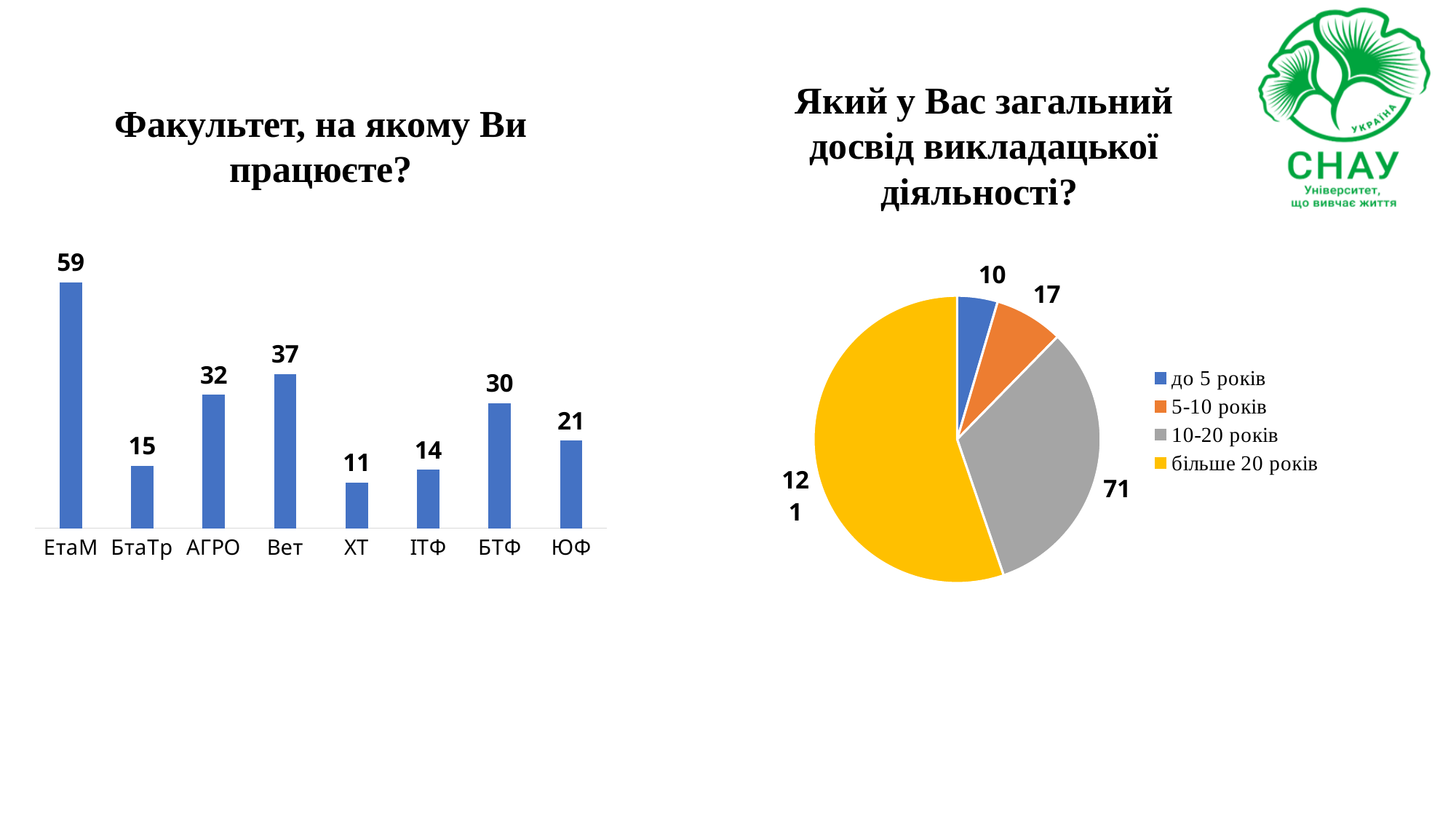
How many faculties are shown in the bar chart on the left? 8 In the bar chart on the left, which is larger: the value for ЮФ or the value for БтаТр? ЮФ In the bar chart on the left, what is the difference between the values for Вет and АГРО? 5 In the bar chart on the left, which faculty has the lowest value? ХТ In the bar chart titled "Факультет, на якому Ви працюєте?", what is the value for ЕтаМ? 59 In the pie chart on the right, which category has the largest slice? більше 20 років In the bar chart titled "Факультет, на якому Ви працюєте?", what is the value for БТФ? 30 What type of chart is the chart on the left of the slide? Bar chart How many categories does the legend of the pie chart on the right list? 4 In the pie chart titled "Який у Вас загальний досвід викладацької діяльності?", what is the value for "10-20 років"? 71 In the bar chart on the left, which faculty has the highest value? ЕтаМ In the pie chart on the right, what is the difference between the values for "5-10 років" and "до 5 років"? 7